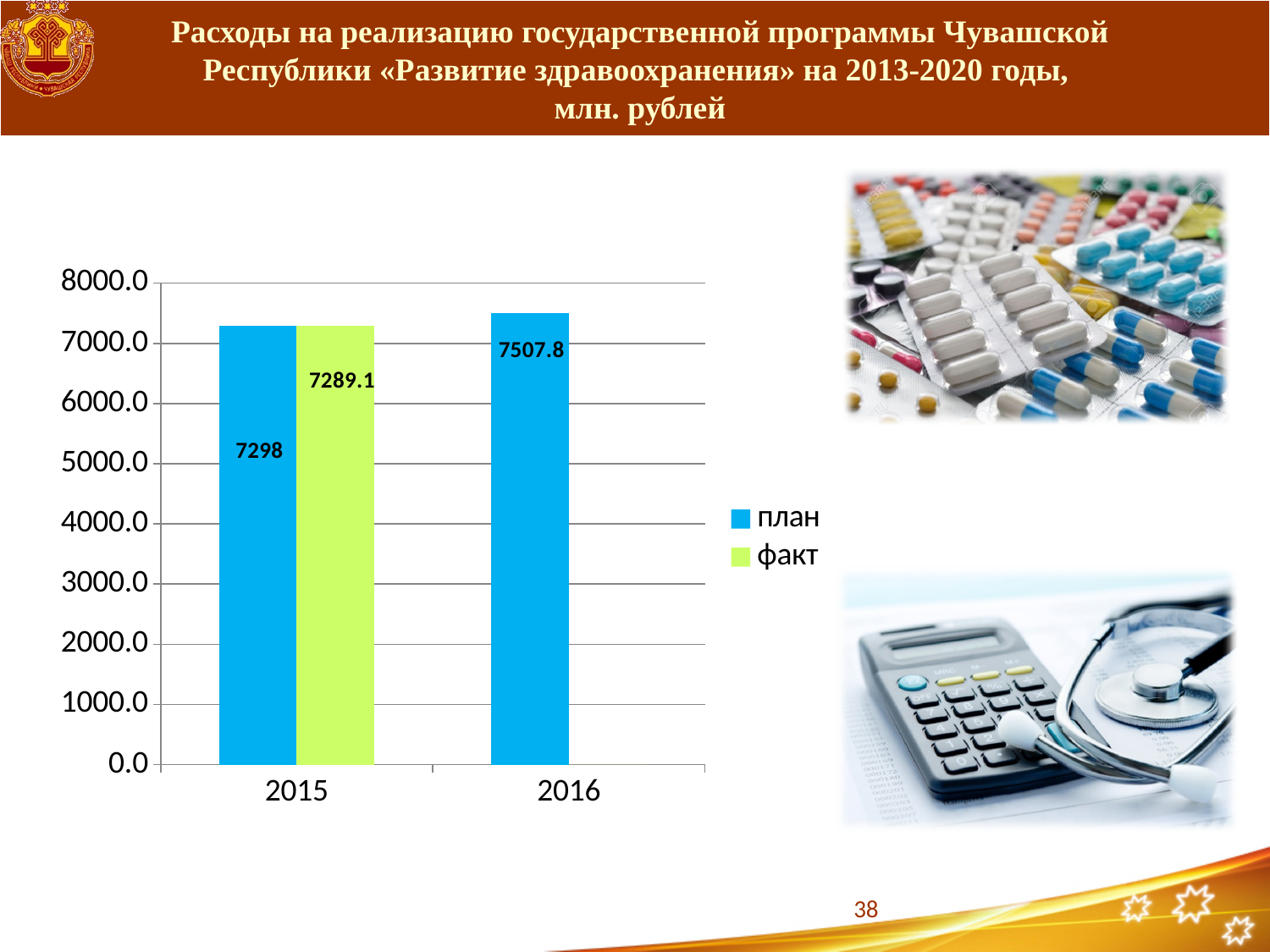
Which series is shown in green in the legend? факт How many series does the legend list? 2 What is the difference between the план values for 2016 and 2015? 209.8 What is the план value for 2016? 7507.8 How many years are shown on the x axis? 2 Is the план value for 2016 greater or less than 7000.0? greater What kind of chart is shown on the slide? bar chart What is the difference between the план and факт values for 2015? 8.9 Which year has the higher план value, 2015 or 2016? 2016 Is the факт value for 2015 greater or less than 8000.0? less What is the факт value for 2015? 7289.1 What is the план value for 2015? 7298